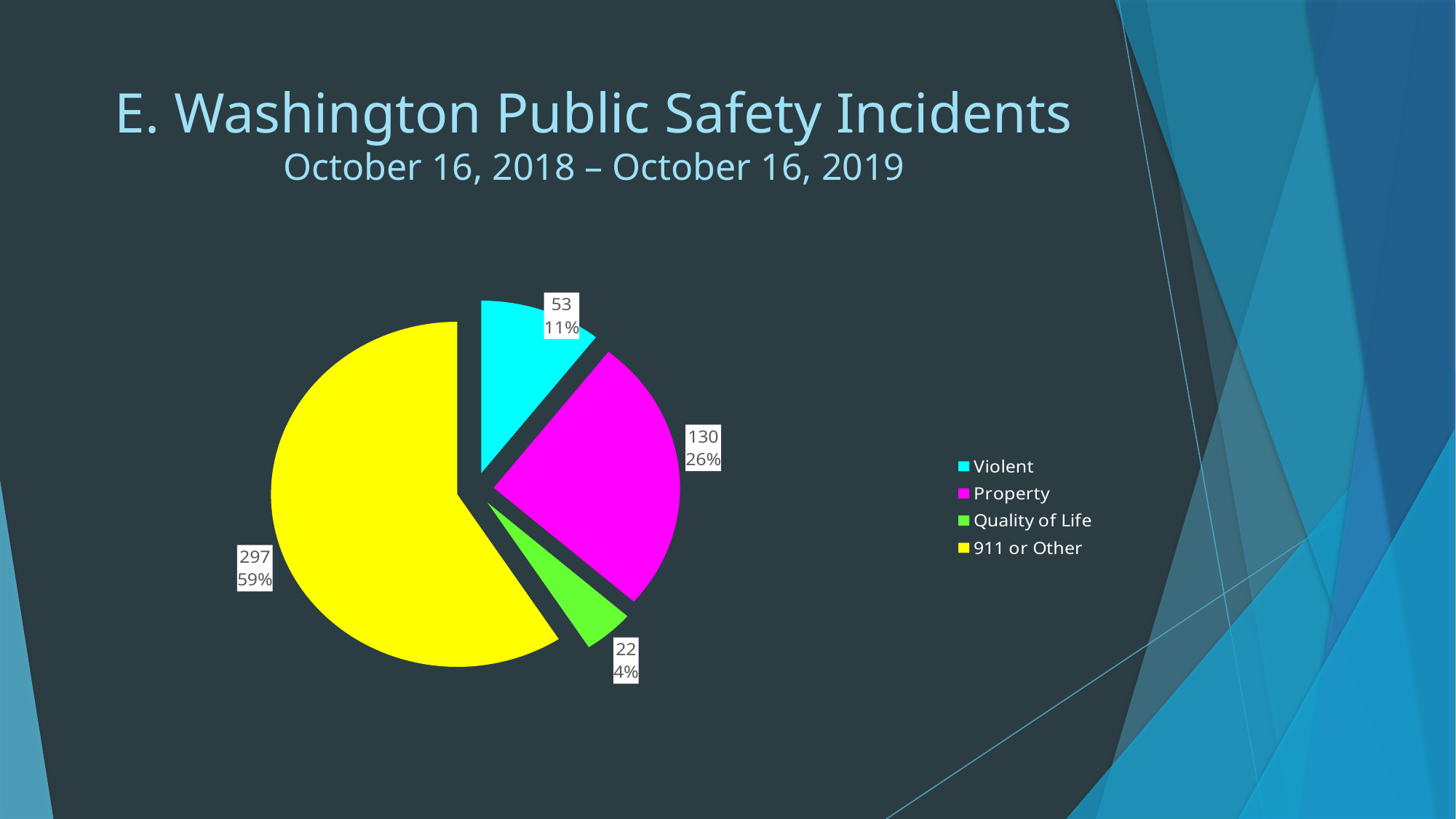
Which category has the smallest slice? Quality of Life What share of the pie does the Property slice represent? 26% How many categories does the legend list? 4 What is the difference between the Property and Violent incident counts? 77 How many incidents are in the Property category? 130 What share of the pie does the 911 or Other slice represent? 59% Which category has the largest slice? 911 or Other What type of chart is shown on the slide? pie chart How many incidents are in the 911 or Other category? 297 Which has more incidents, Violent or Quality of Life? Violent How many incidents are in the Quality of Life category? 22 How many incidents are in the Violent category? 53